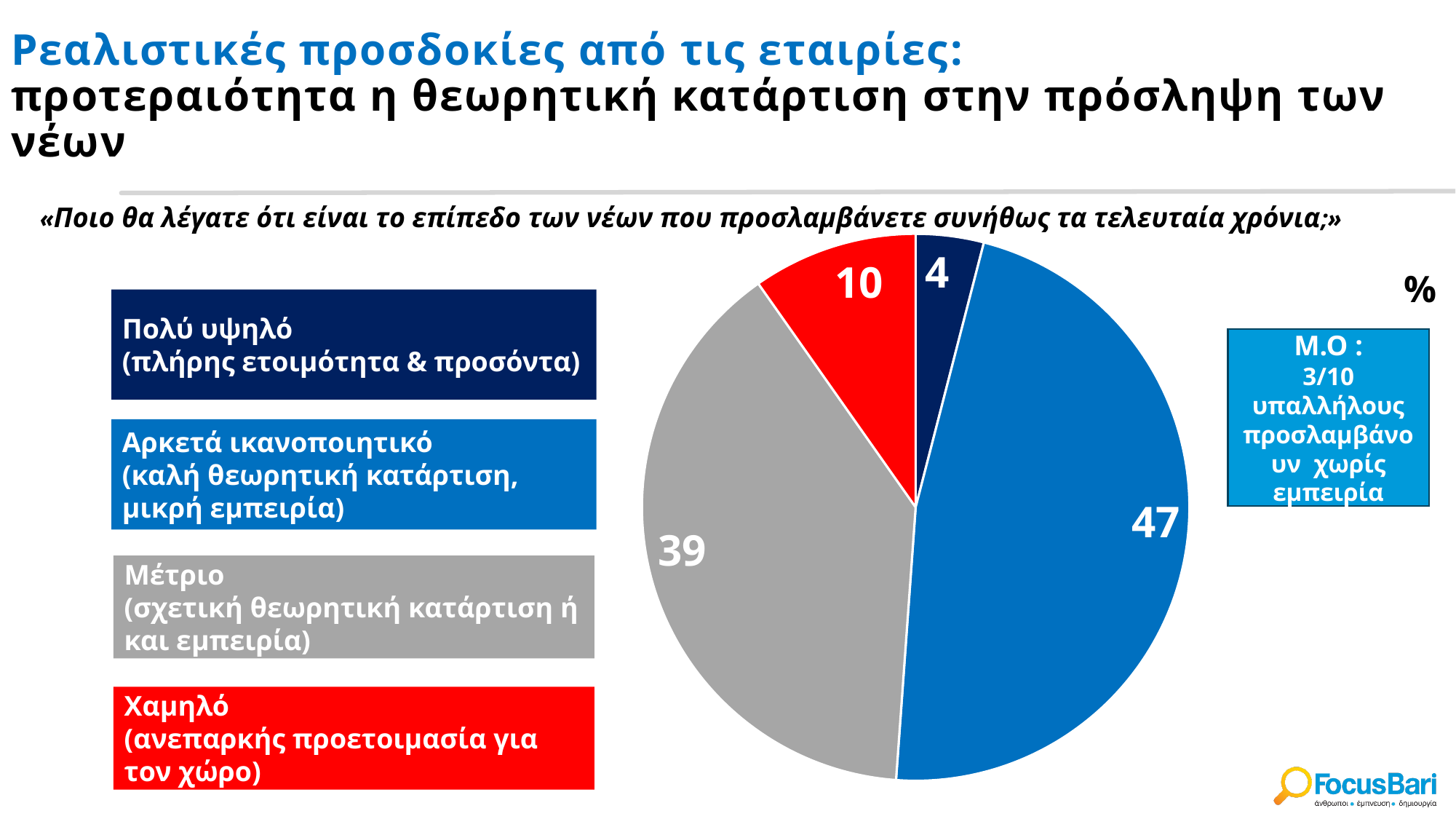
How many slices does the pie chart have? 4 Which category has the largest slice of the pie? Αρκετά ικανοποιητικό What is the value for the 'Μέτριο' slice? 39 What colour is the 'Χαμηλό' slice in the pie chart? red Which category has the smallest slice of the pie? Πολύ υψηλό What is the value for the 'Πολύ υψηλό' slice? 4 What is the value for the 'Αρκετά ικανοποιητικό' slice? 47 What type of chart is shown on the slide? pie chart What colour is the 'Μέτριο' slice in the pie chart? grey Which is larger, the 'Χαμηλό' slice or the 'Πολύ υψηλό' slice? Χαμηλό What is the difference between the 'Αρκετά ικανοποιητικό' and 'Μέτριο' values? 8 What is the value for the 'Χαμηλό' slice? 10